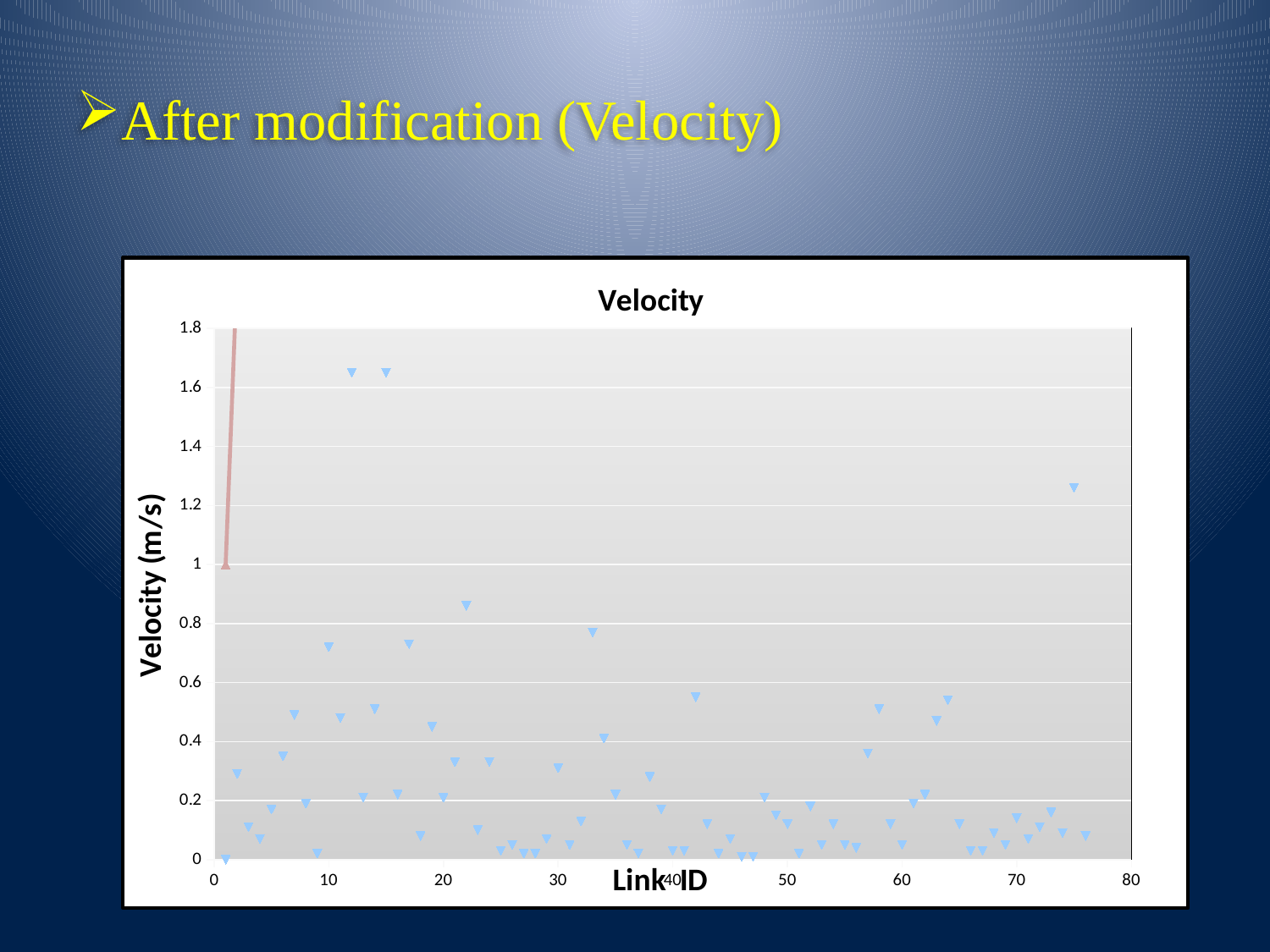
Is the value for the point near Link ID 10 greater or less than 0.6? greater Which has the higher velocity, the point near Link ID 75 or the point near Link ID 22? the point near Link ID 75 Is the value for the point near Link ID 58 greater or less than 0.6? less What is the highest value shown on the vertical axis of the chart? 1.8 Is the value for the point near Link ID 2 greater or less than 0.4? less What kind of chart is shown on the slide? scatter chart Which has the higher velocity, the point near Link ID 22 or the point near Link ID 10? the point near Link ID 22 What is the label of the vertical axis of the chart? Velocity (m/s) What is the title of the chart? Velocity